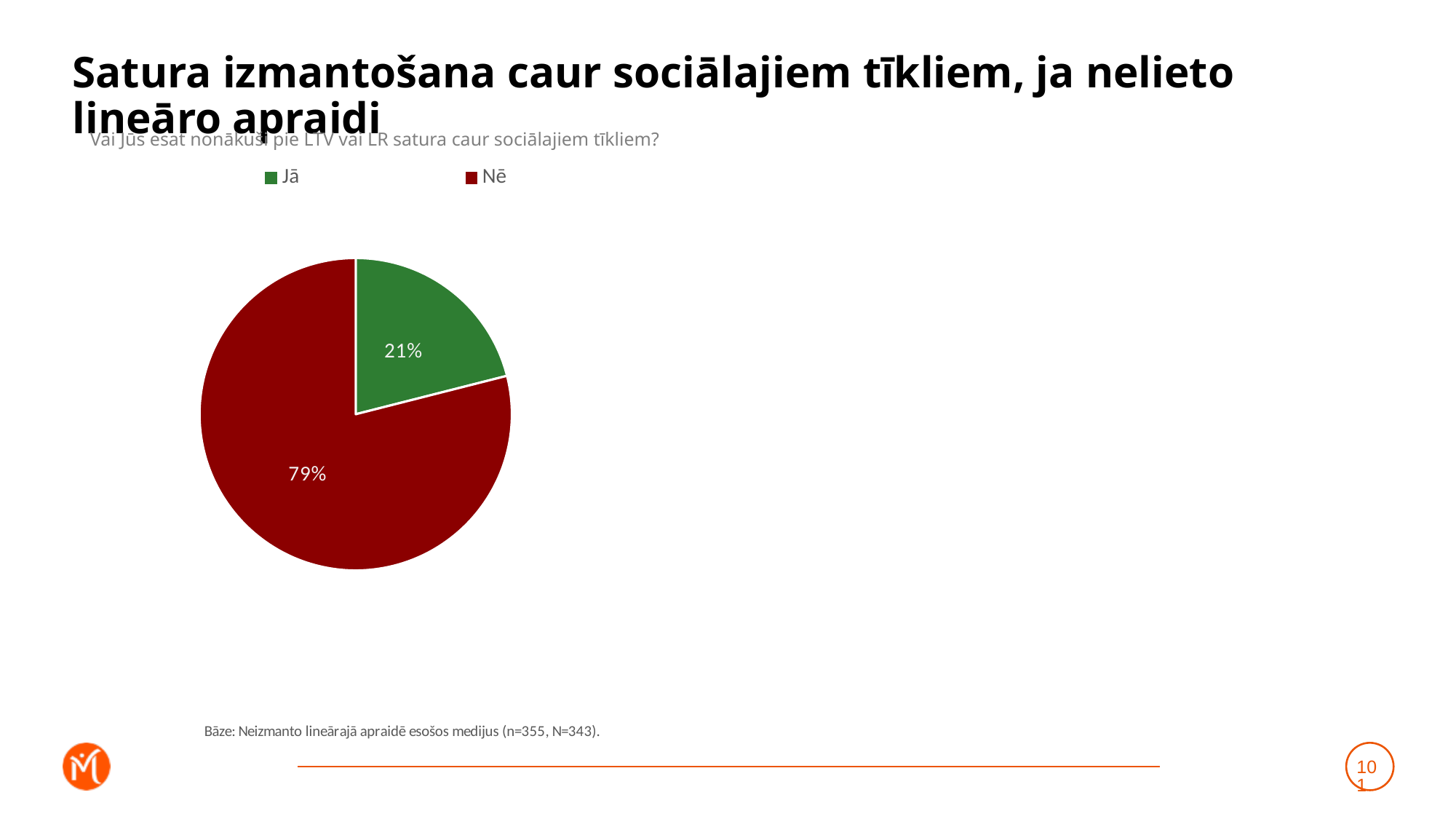
What share of the pie does "Jā" represent? 21% What kind of chart is shown on the slide? pie chart Which slice is the largest in the pie chart? Nē Which slice is the smallest in the pie chart? Jā Which is larger, the "Jā" slice or the "Nē" slice? Nē What colour is the "Nē" slice? dark red How many entries does the legend list? 2 How many slices does the pie chart have? 2 What share of the pie does "Nē" represent? 79% What colour is the "Jā" slice? green What is the difference in percentage points between the "Nē" and "Jā" slices? 58